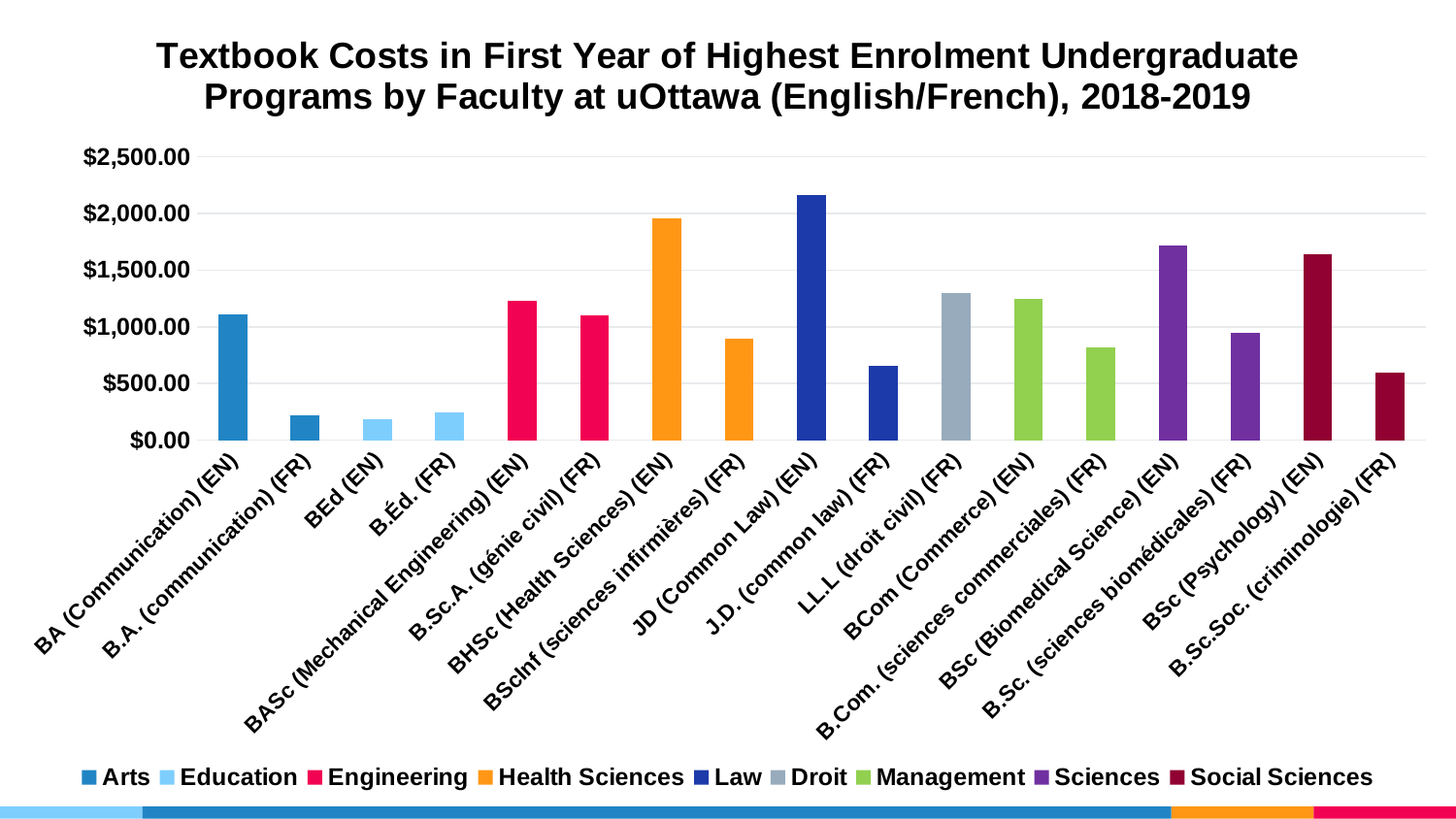
Which program has the highest textbook cost in the chart? JD (Common Law) (EN) Which is larger, the value for LL.L (droit civil) (FR) or J.D. (common law) (FR)? LL.L (droit civil) (FR) Is the value for BEd (EN) greater or less than $500.00? less Which faculty is represented by the orange bars in the legend? Health Sciences Is the value for BSc (Biomedical Science) (EN) greater or less than $1,500.00? greater How many faculties does the legend list? 9 What kind of chart is shown on the slide? Bar chart How many programs (bars) are plotted in the chart? 17 Is the value for BScInf (sciences infirmières) (FR) greater or less than $1,000.00? less Which is larger, the value for BCom (Commerce) (EN) or B.Com. (sciences commerciales) (FR)? BCom (Commerce) (EN)